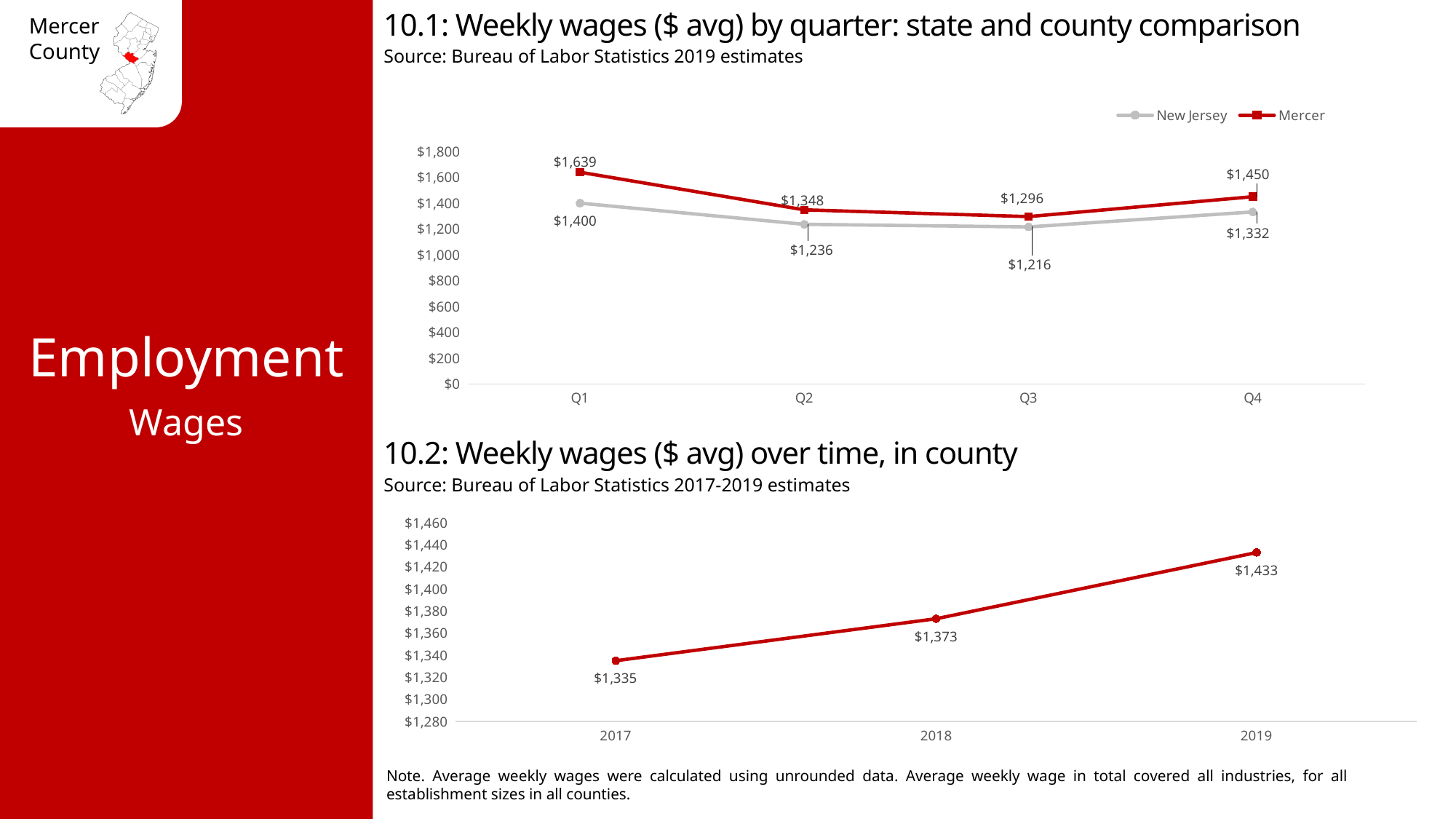
In chart 10.1, which series has the higher weekly wage in Q2, New Jersey or Mercer? Mercer In chart 10.1, what is the difference between the Mercer and New Jersey weekly wages in Q4? $118 In chart 10.1, in which quarter is the Mercer weekly wage lowest? Q3 In chart 10.1, what is the New Jersey weekly wage in Q3? $1,216 In chart 10.2, what is the difference between the 2019 and 2017 weekly wages? $98 In chart 10.1, how many series does the legend list? 2 In chart 10.2, what is the weekly wage in 2018? $1,373 In chart 10.1, how many quarters are shown on the x axis? 4 What kind of chart is chart 10.2? Line chart In chart 10.1, in which quarter is the New Jersey weekly wage highest? Q1 In chart 10.1, what is the Mercer weekly wage in Q1? $1,639 In chart 10.2, do weekly wages rise or fall from 2017 to 2019? Rise